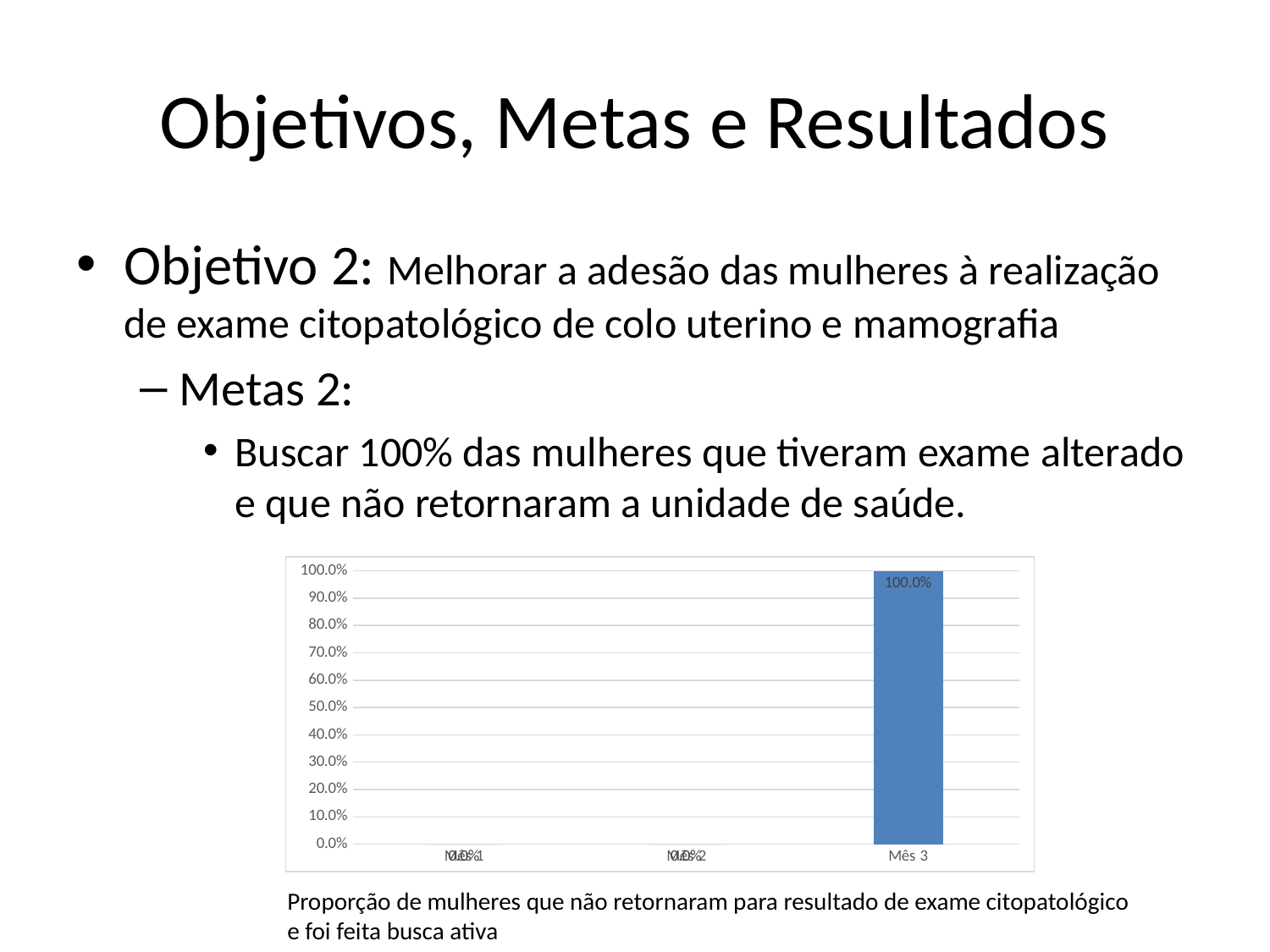
Is the value for Mês 2 greater or less than 50.0%? less Which month has the highest value in the chart? Mês 3 What kind of chart is shown on the slide? Bar chart How many months (categories) are shown on the x axis of the chart? 3 What is the value shown for Mês 3? 100.0% Do the values rise or fall from Mês 1 to Mês 3? rise What is the highest value shown on the y axis of the chart? 100.0% Which is larger, the value for Mês 3 or the value for Mês 1? Mês 3 What colour is the bar for Mês 3? Blue Is the value for Mês 1 greater or less than 50.0%? less